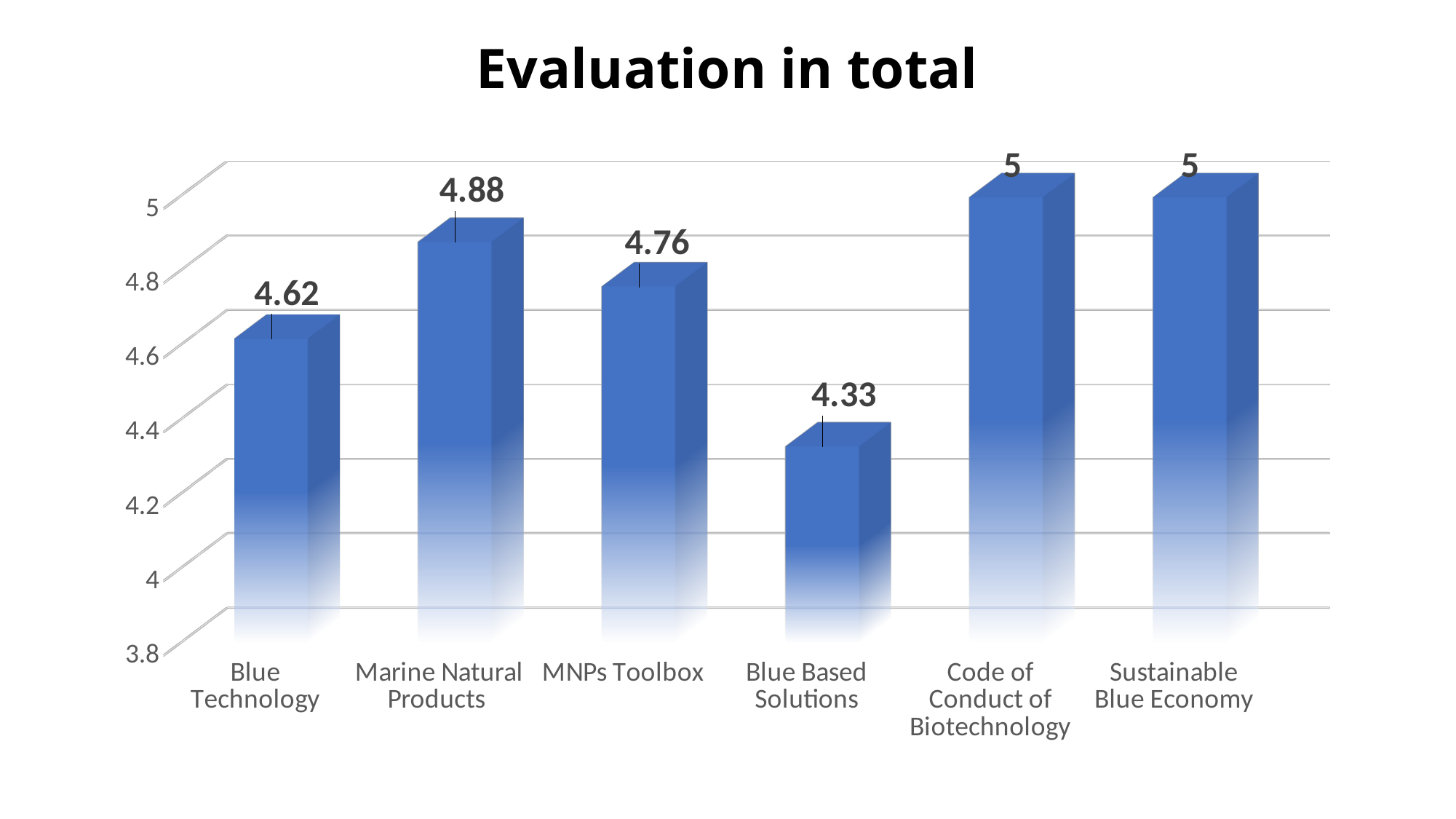
What kind of chart is this? Bar chart What is the title of the chart? Evaluation in total What is the value for Marine Natural Products? 4.88 What is the value for Blue Based Solutions? 4.33 What is the value for Code of Conduct of Biotechnology? 5 What is the difference between the values for MNPs Toolbox and Blue Based Solutions? 0.43 Which category has the lowest value? Blue Based Solutions What is the value for Blue Technology? 4.62 Which is larger, the value for Marine Natural Products or the value for MNPs Toolbox? Marine Natural Products How many categories are shown on the chart? 6 What is the value for MNPs Toolbox? 4.76 What is the difference between the values for Marine Natural Products and Blue Technology? 0.26